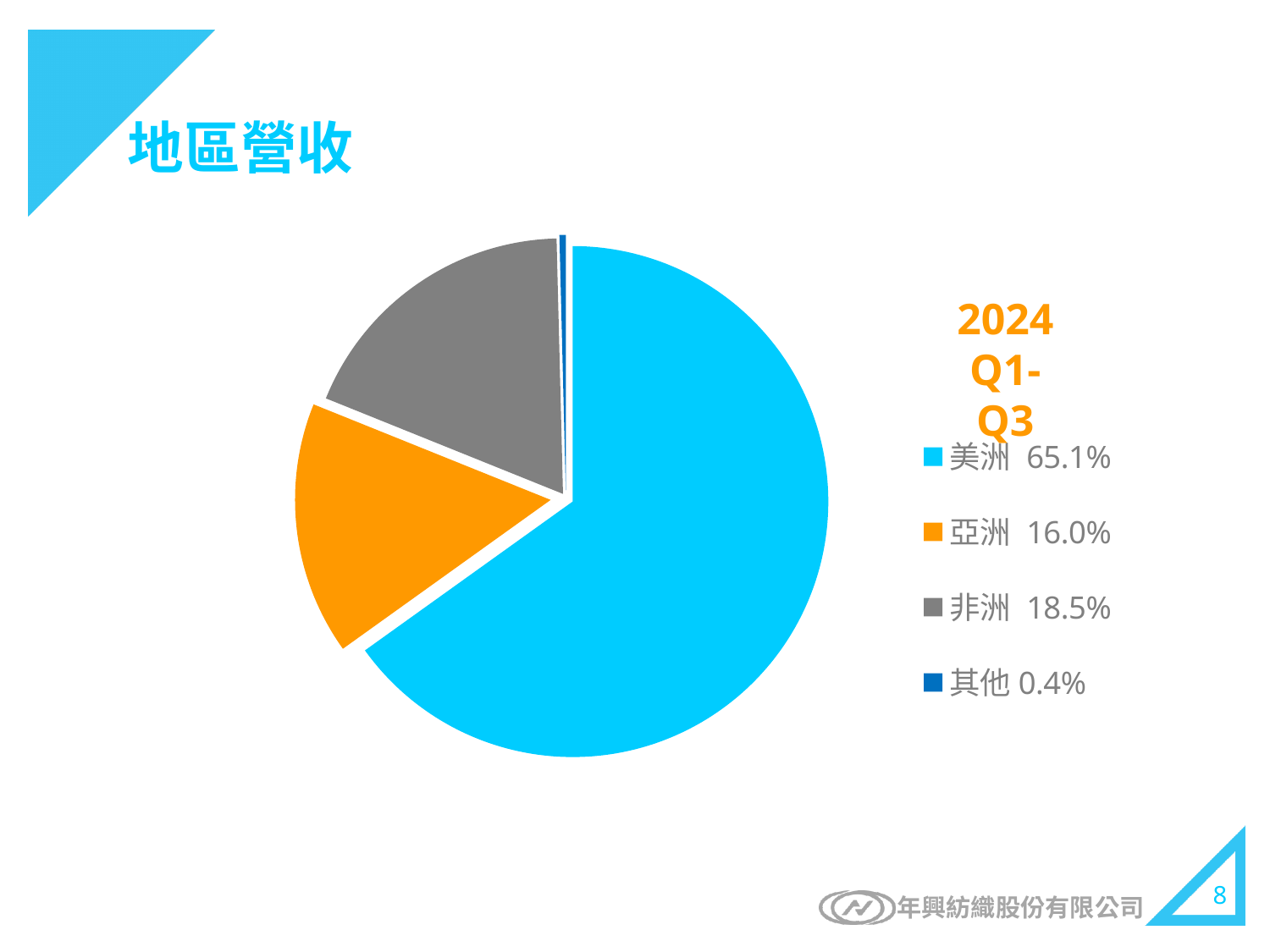
How many regions are shown in the pie chart? 4 What colour is the slice for 亞洲? orange What share of regional revenue does 非洲 account for? 18.5% Which region has the largest share of revenue? 美洲 What kind of chart is shown on the slide? pie chart What share of regional revenue does 美洲 account for? 65.1% What period does the chart cover, according to the label next to the legend? 2024 Q1-Q3 What share of regional revenue does 其他 account for? 0.4% Which has a larger share, 亞洲 or 非洲? 非洲 Which region has the smallest share of revenue? 其他 What is the difference in percentage points between the shares of 非洲 and 亞洲? 2.5 What share of regional revenue does 亞洲 account for? 16.0%